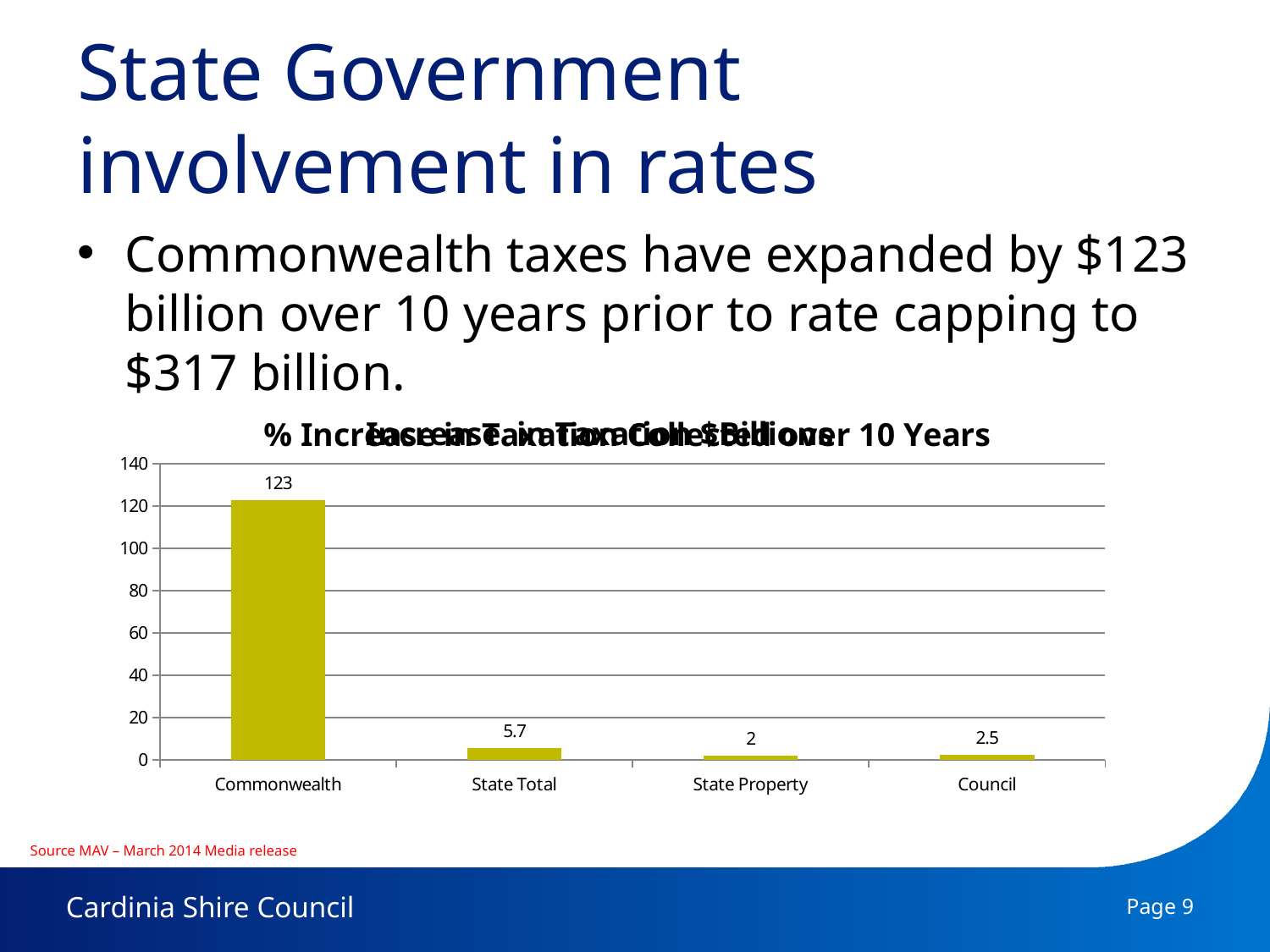
What is the difference between the Commonwealth value and the State Total value? 117.3 What is the value for Commonwealth in the bar chart? 123 Which is larger, the value for State Total or the value for Council? State Total What is the difference between the Council value and the State Property value? 0.5 Is the value for Commonwealth greater or less than 100? greater What is the value for Council in the bar chart? 2.5 What is the value for State Property in the bar chart? 2 Which category has the lowest value in the bar chart? State Property How many categories are shown on the x axis of the bar chart? 4 What is the value for State Total in the bar chart? 5.7 What kind of chart is shown on the slide? bar chart Which category has the highest value in the bar chart? Commonwealth